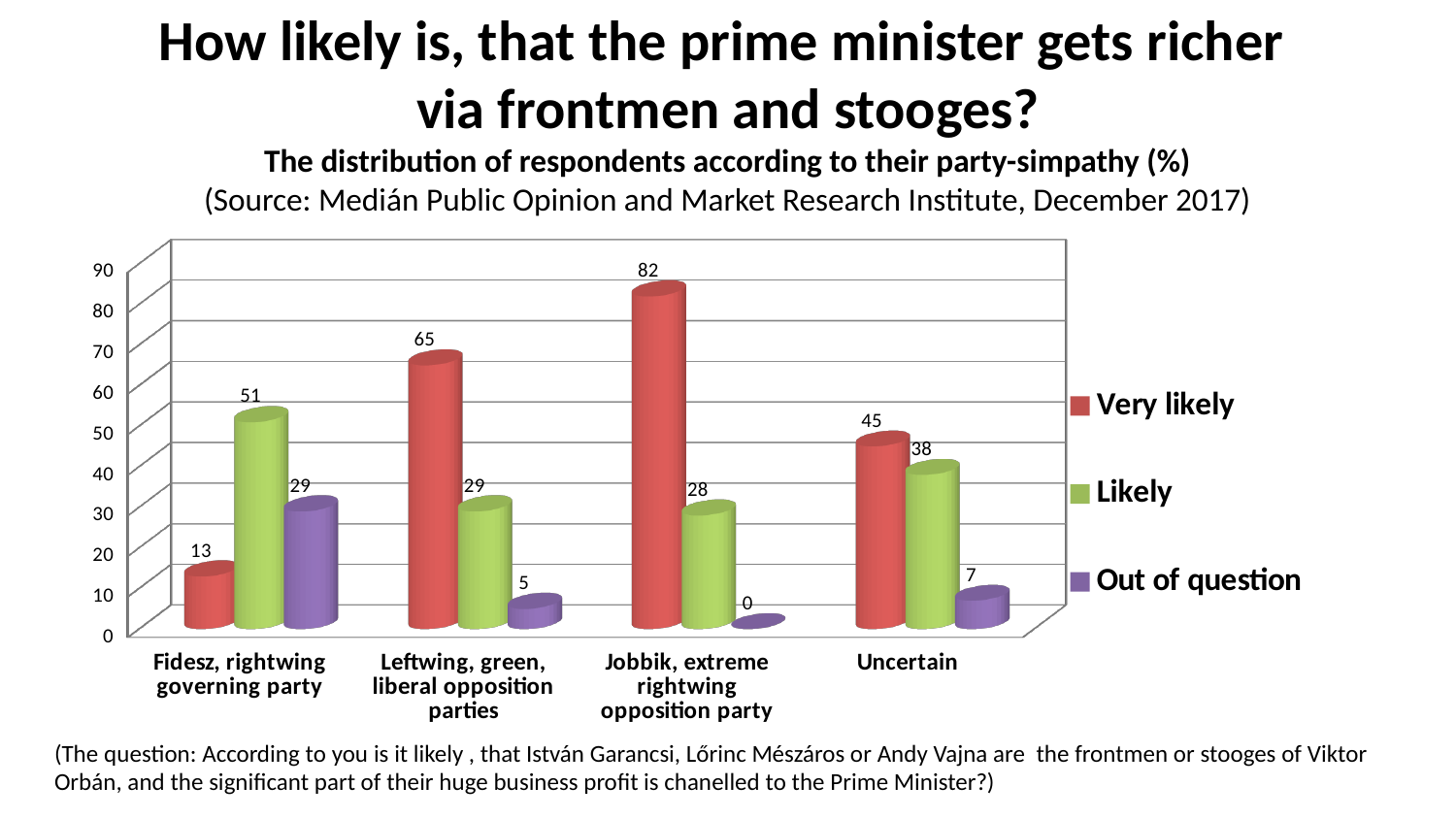
Which colour represents the 'Out of question' series? Purple How many series does the legend list? 3 How many party categories are shown on the x axis? 4 What is the difference between the 'Very likely' values for Jobbik and Fidesz? 69 Which is larger for Uncertain respondents: 'Very likely' or 'Likely'? Very likely Which category has the highest 'Very likely' value? Jobbik, extreme rightwing opposition party What kind of chart is shown on the slide? Bar chart What is the 'Out of question' value for Leftwing, green, liberal opposition parties? 5 What is the 'Very likely' value for Jobbik, extreme rightwing opposition party? 82 What is the 'Very likely' value for Uncertain respondents? 45 Which category has the lowest 'Out of question' value? Jobbik, extreme rightwing opposition party What is the 'Likely' value for Fidesz, rightwing governing party? 51